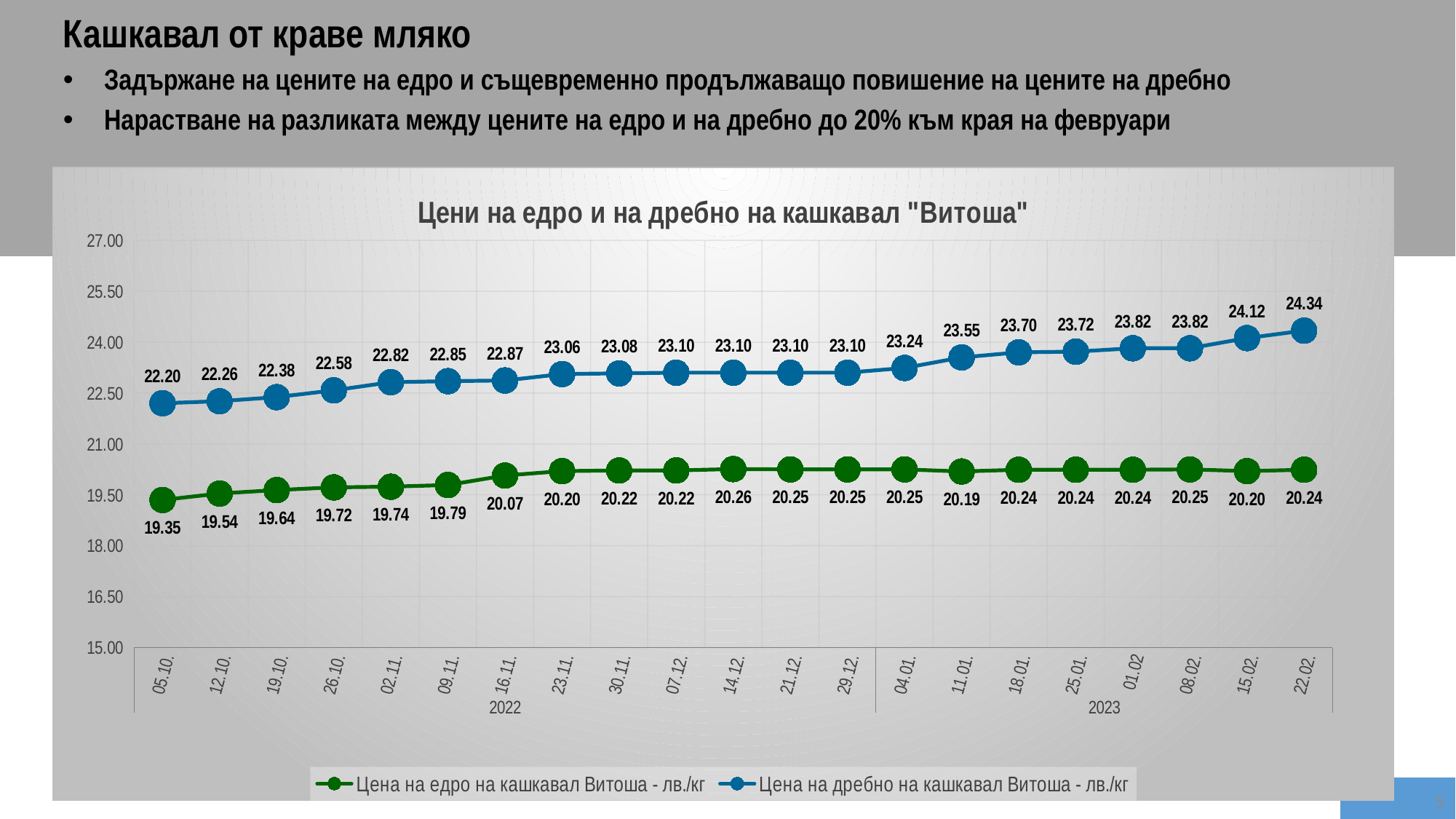
What is the difference between the retail and wholesale price on 22.02.? 4.10 Does the retail price (Цена на дребно) rise or fall over the period shown? rise What is the wholesale price (Цена на едро) of kashkaval Vitosha on 05.10.? 19.35 How many dates are plotted along the x axis? 21 On which date is the retail price (Цена на дребно) highest? 22.02. What kind of chart is shown on the slide? line chart What is the retail price (Цена на дребно) of kashkaval Vitosha on 22.02.? 24.34 What is the wholesale price (Цена на едро) on 11.01.? 20.19 On which date is the wholesale price (Цена на едро) lowest? 05.10. How many series does the legend list? 2 By how much did the retail price (Цена на дребно) increase from 05.10. to 22.02.? 2.14 Is the retail price (Цена на дребно) on 05.10. greater or less than 22.50? less